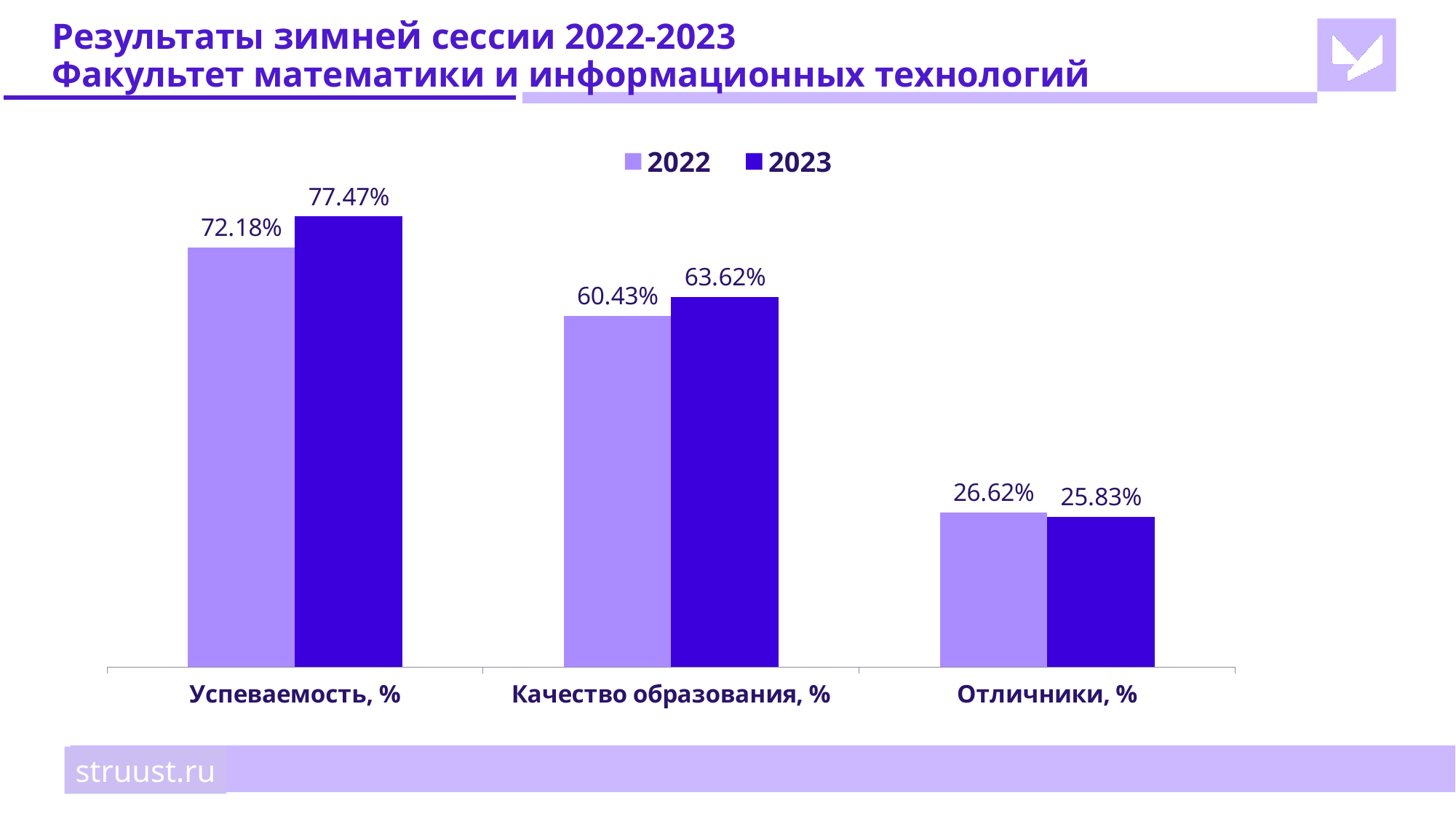
For Отличники, %, which year has the larger value, 2022 or 2023? 2022 What is the value for Отличники, % in 2022? 26.62% How many series does the legend list? 2 What is the difference between the 2023 and 2022 values for Успеваемость, %? 5.29% How many categories are shown on the x axis? 3 Which category has the lowest value in the 2022 series? Отличники, % What kind of chart is shown on the slide? Bar chart What is the value for Качество образования, % in 2023? 63.62% What is the value for Успеваемость, % in 2022? 72.18% What is the value for Успеваемость, % in 2023? 77.47% What is the difference between the 2023 and 2022 values for Качество образования, %? 3.19% Which category has the highest value in the 2023 series? Успеваемость, %